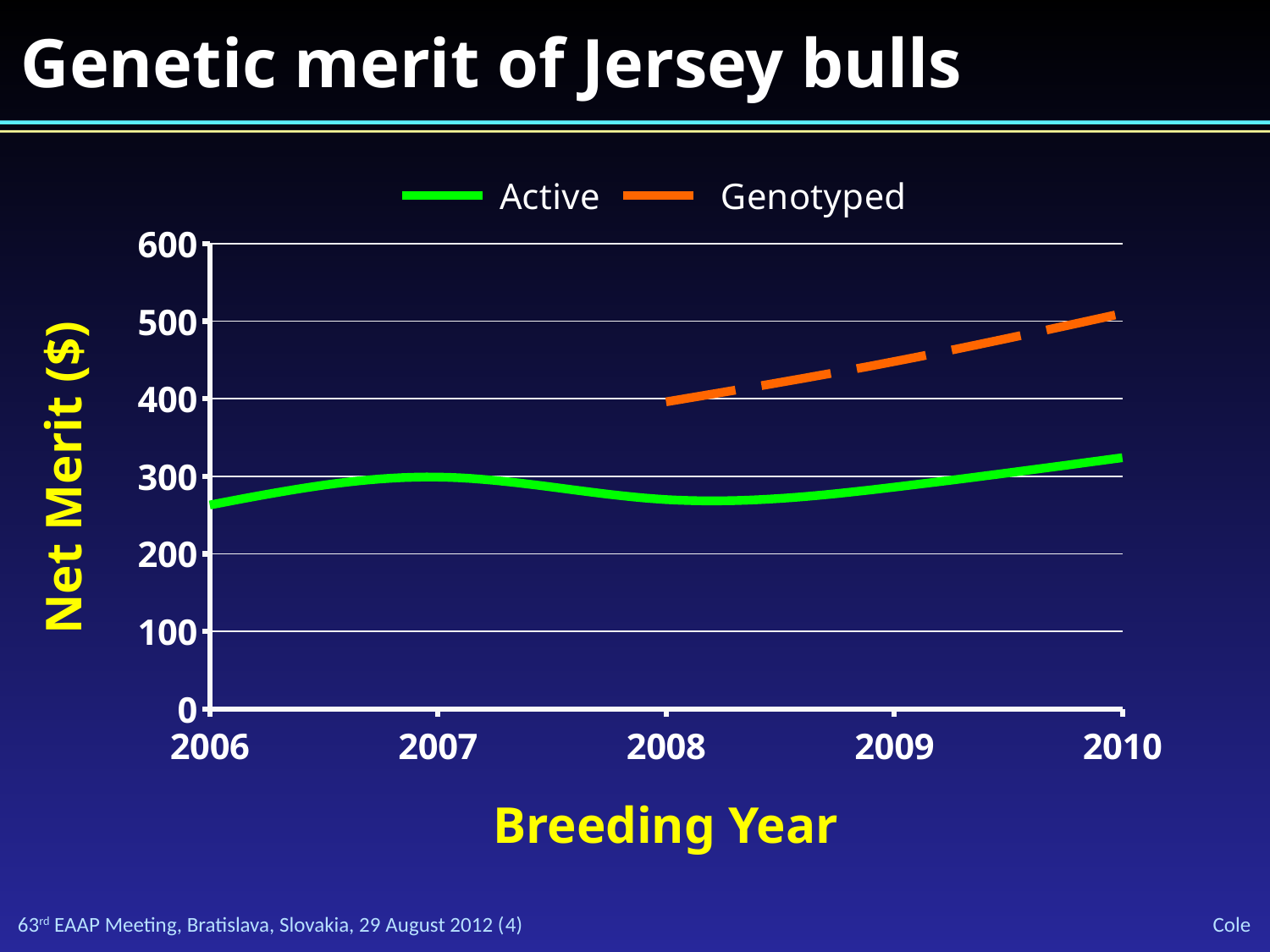
What is the title of the y axis? Net Merit ($) What is the title of the x axis? Breeding Year Is the Active value for 2006 greater or less than 300? less What kind of chart is shown on the slide? line chart How many series does the legend list? 2 In 2010, which series has the larger Net Merit, Active or Genotyped? Genotyped Does the Genotyped series rise or fall from 2008 to 2010? rise In which breeding year is the Genotyped series highest? 2010 Is the Genotyped value for 2009 greater or less than 400? greater In which breeding year is the Active series highest? 2010 How many breeding years are labelled on the x axis? 5 Is the Active value for 2010 greater or less than 300? greater